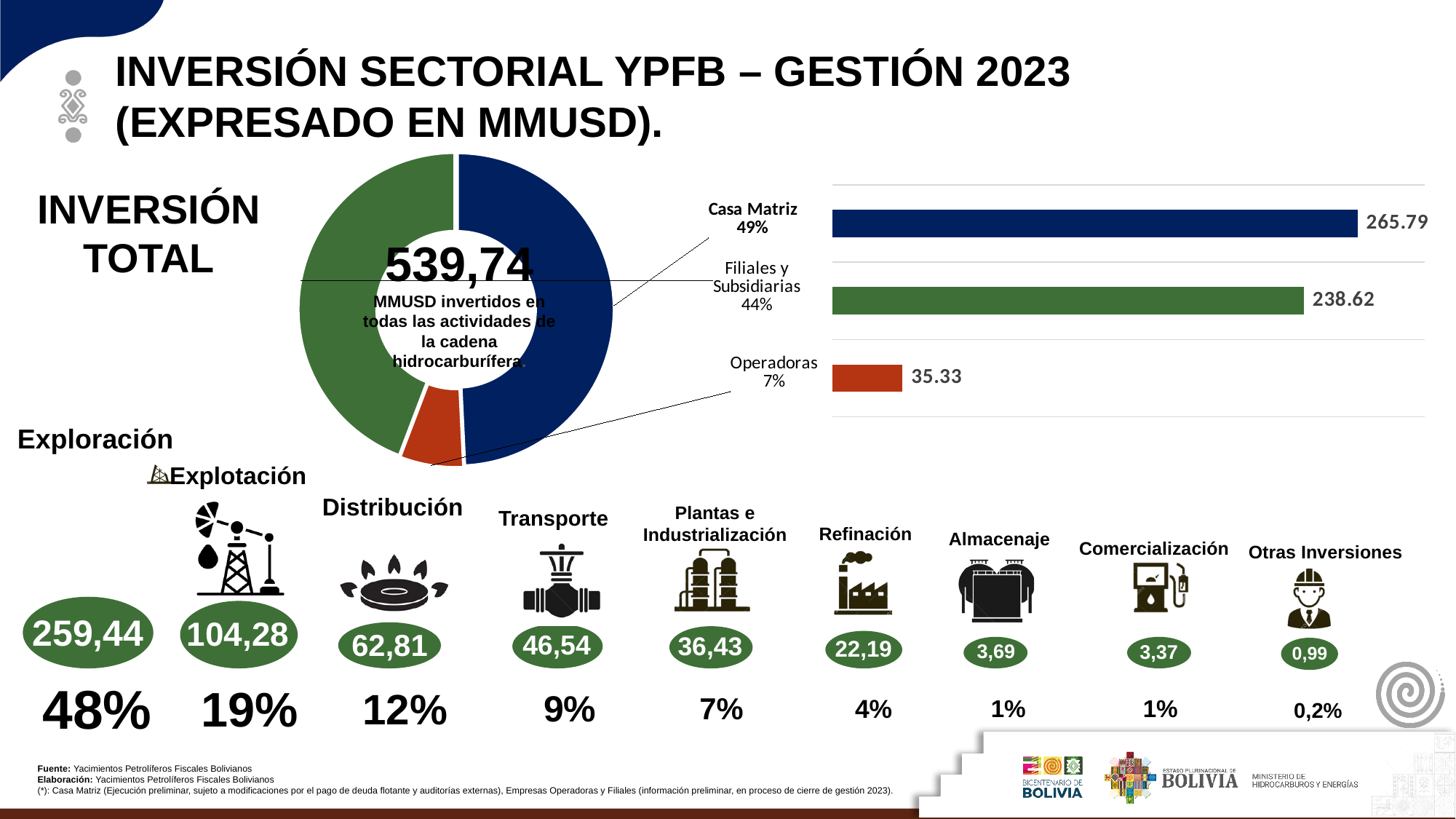
In the donut chart, what share does Operadoras represent? 7% What kind of chart is shown on the right side of the slide? Bar chart In the bar chart on the right, what is the value for Filiales y Subsidiarias? 238.62 In the bar chart on the right, what is the value for Operadoras? 35.33 In the bar chart on the right, what is the difference between the Casa Matriz and Filiales y Subsidiarias values? 27.17 In the donut chart, what share does Casa Matriz represent? 49% In the bar chart on the right, what is the value for Casa Matriz? 265.79 In the bar chart on the right, which category has the highest value? Casa Matriz In the bar chart on the right, which category has the lowest value? Operadoras In the bar chart on the right, how many bars are plotted? 3 In the donut chart, which is larger: the share for Filiales y Subsidiarias or the share for Operadoras? Filiales y Subsidiarias What total value is printed in the centre of the donut chart? 539,74